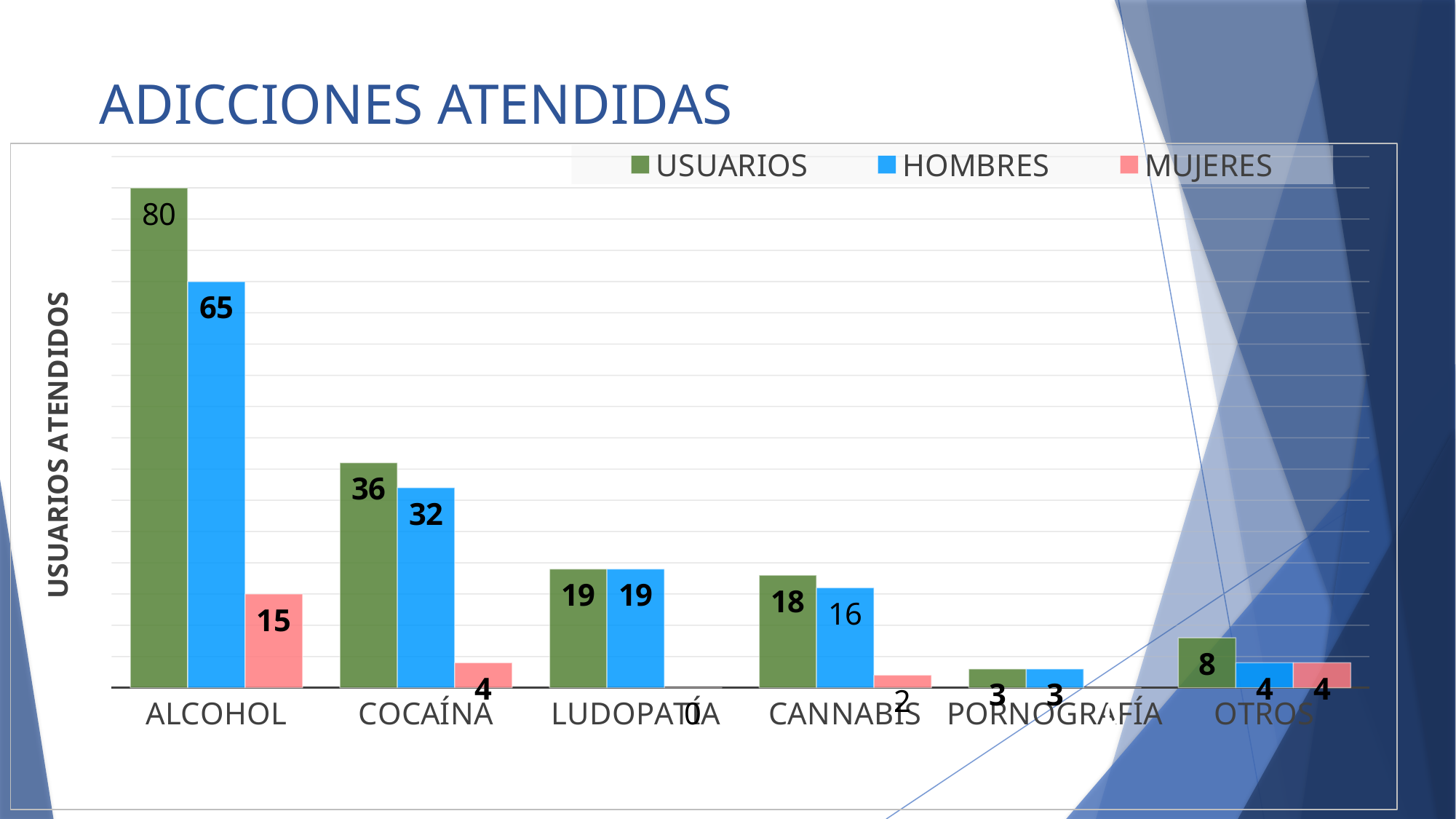
What is the HOMBRES value for CANNABIS? 16 How many categories are shown on the x axis? 6 What is the USUARIOS value for ALCOHOL? 80 Which category has the highest USUARIOS value? ALCOHOL How many series does the legend list? 3 What is the HOMBRES value for COCAÍNA? 32 Which is larger, the USUARIOS value for COCAÍNA or the USUARIOS value for LUDOPATÍA? COCAÍNA What kind of chart is shown on the slide? Bar chart What is the MUJERES value for ALCOHOL? 15 What is the difference between the USUARIOS value and the HOMBRES value for ALCOHOL? 15 Which category has the lowest USUARIOS value? PORNOGRAFÍA What is the title of the y axis? USUARIOS ATENDIDOS